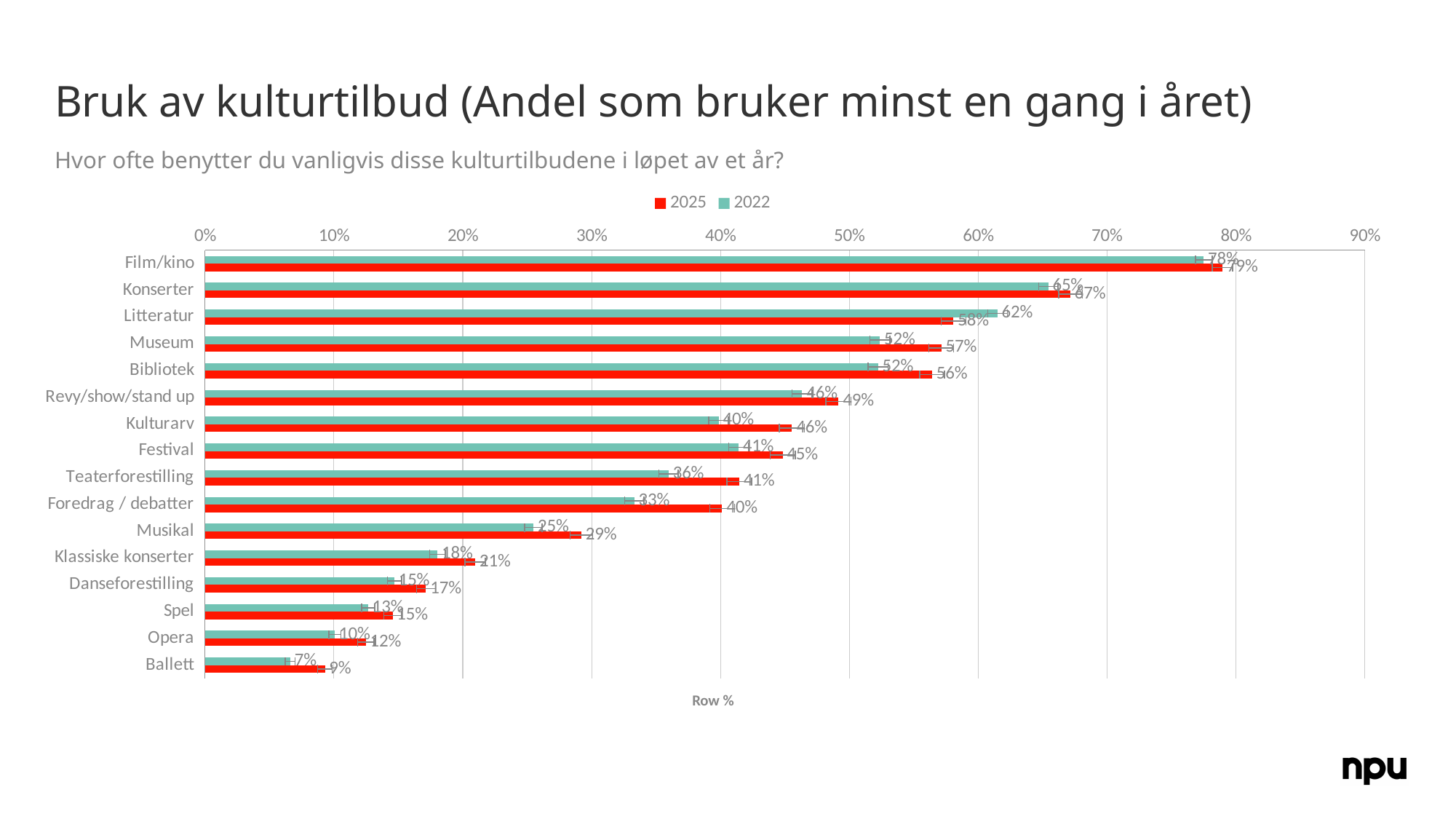
Which series is shown in red in the legend? 2025 What is the 2022 value for Foredrag / debatter? 33% What is the difference between the 2025 and 2022 values for Kulturarv? 6% How many series does the legend list? 2 Is the 2025 value for Teaterforestilling greater or less than 30%? greater Which category has the highest 2025 value? Film/kino Which category has the lowest 2022 value? Ballett What kind of chart is shown on the slide? bar chart How many categories are plotted on the chart? 16 What is the 2025 value for Musikal? 29% What is the 2025 value for Museum? 57% Which is larger for Litteratur, the 2022 value or the 2025 value? 2022